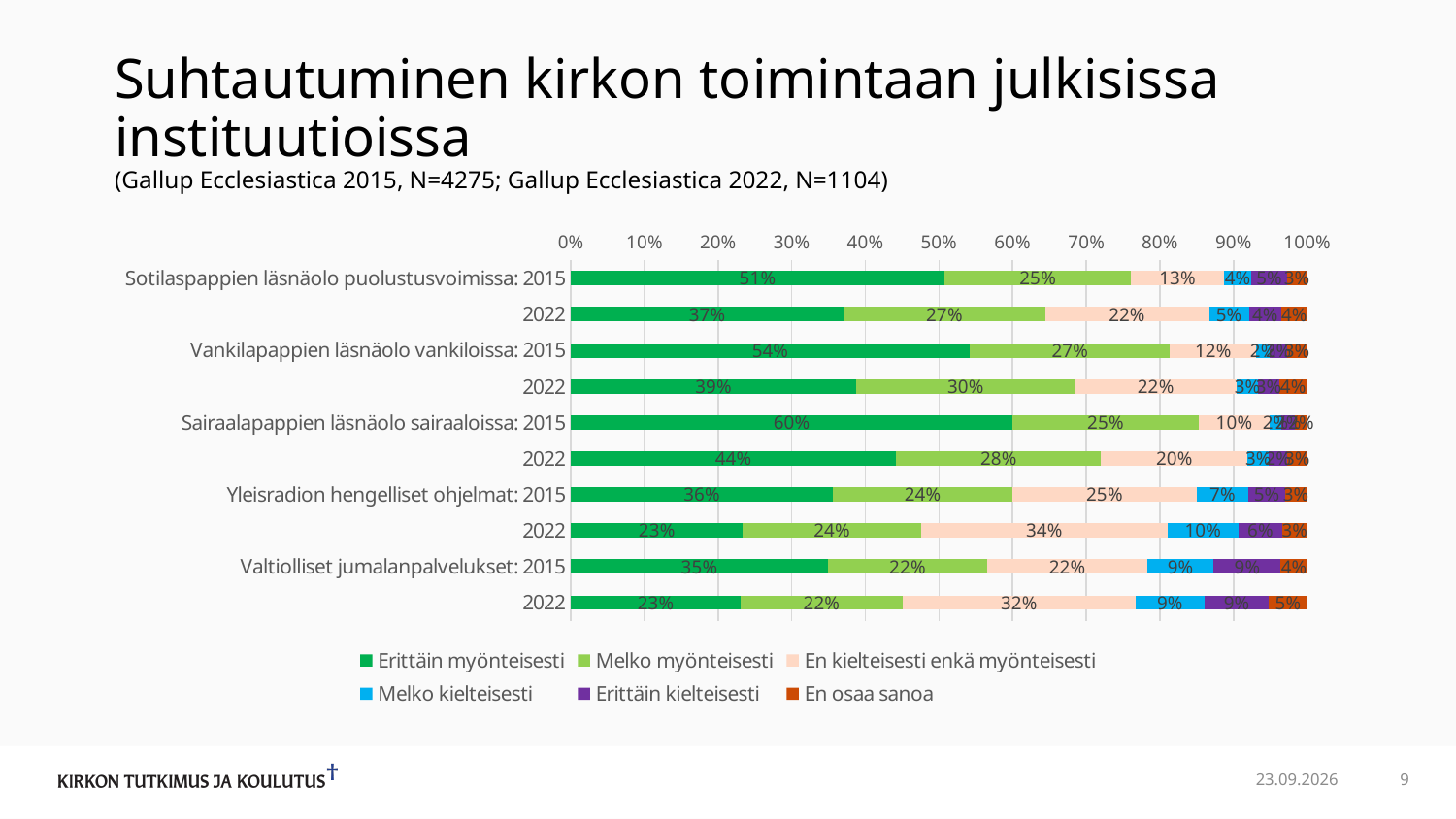
Which is larger: the 'Erittäin myönteisesti' share for 'Vankilapappien läsnäolo vankiloissa' in 2015 or for 'Yleisradion hengelliset ohjelmat' in 2015? Vankilapappien läsnäolo vankiloissa: 2015 Is the 'Erittäin myönteisesti' value for 'Valtiolliset jumalanpalvelukset' in 2022 greater or less than 30%? less What kind of chart is shown on the slide? Stacked bar chart How many bars are plotted in the chart? 10 What is the 'Erittäin myönteisesti' value for 'Sairaalapappien läsnäolo sairaaloissa' in 2015? 60% What is the 'En kielteisesti enkä myönteisesti' value for 'Yleisradion hengelliset ohjelmat' in 2022? 34% What is the 'Melko kielteisesti' value for 'Valtiolliset jumalanpalvelukset' in 2015? 9% What is the difference in the 'Erittäin myönteisesti' share for 'Sotilaspappien läsnäolo puolustusvoimissa' between 2015 (51%) and 2022 (37%)? 14 percentage points What is the 'Melko myönteisesti' value for 'Vankilapappien läsnäolo vankiloissa' in 2022? 30% What is the first series listed in the legend? Erittäin myönteisesti Which bar has the highest 'Erittäin myönteisesti' share? Sairaalapappien läsnäolo sairaaloissa: 2015 How many series does the legend list? 6